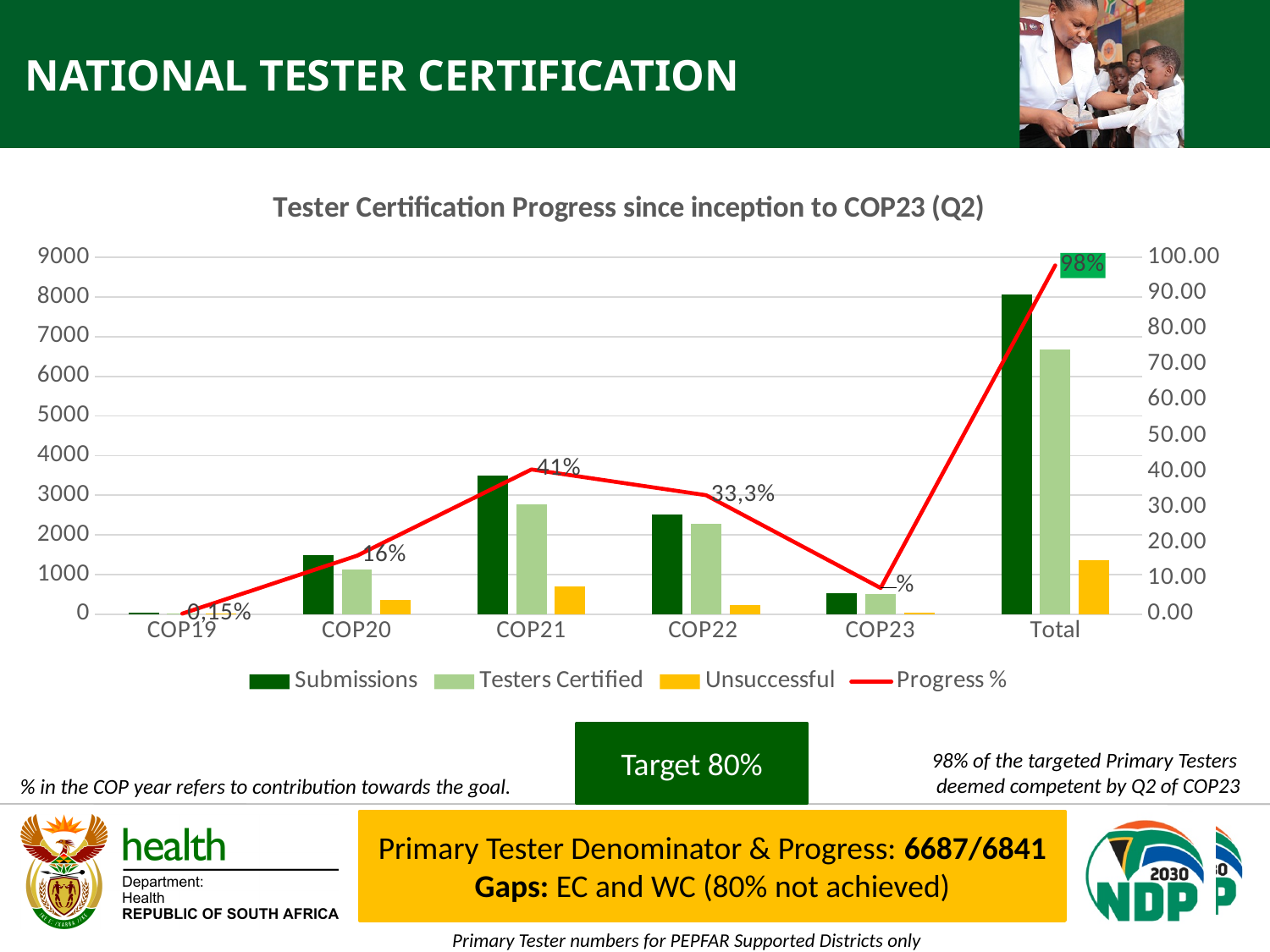
What is the difference between the Progress % for COP21 and COP20? 25% What is the Progress % value shown for Total? 98% What is the Progress % value for COP22? 33,3% Which category has the lowest Submissions bar? COP19 How many series does the legend list? 4 Is the Testers Certified value for COP21 greater or less than 2000? greater What is the Progress % value for COP21? 41% How many categories are shown on the x axis? 6 Is the Submissions value for Total greater or less than 7000? greater Which has a larger Progress % value, COP21 or COP22? COP21 Which category has the highest Progress % value? Total What is the Progress % value for COP19? 0,15%